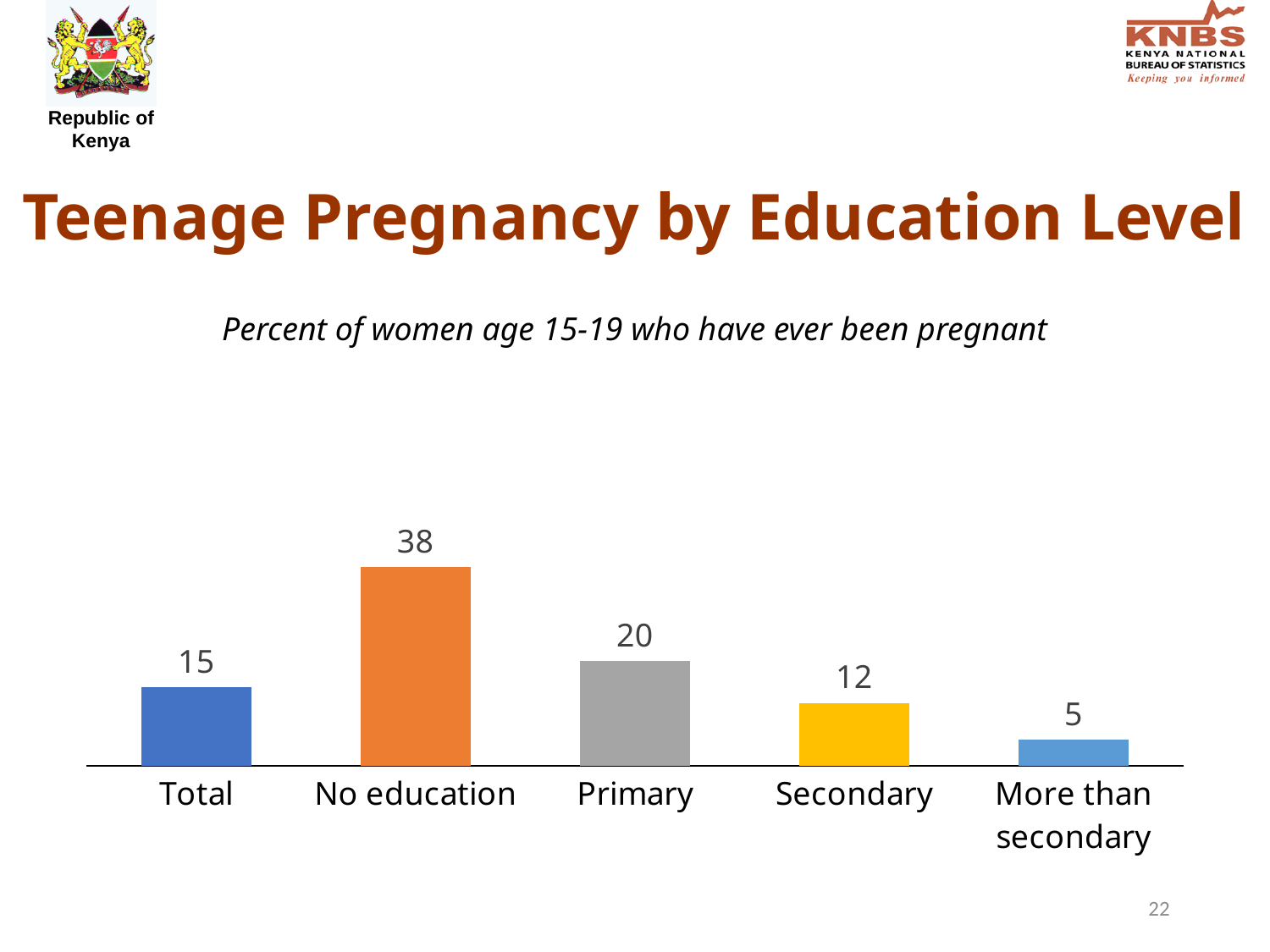
What is the title of the chart on the slide? Teenage Pregnancy by Education Level What is the value for No education? 38 What kind of chart is shown on the slide? Bar chart What is the value for More than secondary? 5 What is the difference between the values for Secondary and More than secondary? 7 What is the value for Primary? 20 Which category has the lowest value? More than secondary What is the difference between the values for No education and Primary? 18 How many categories are shown in the chart? 5 What is the value for Total? 15 Which is larger, the value for Total or the value for Secondary? Total Which category has the highest value? No education